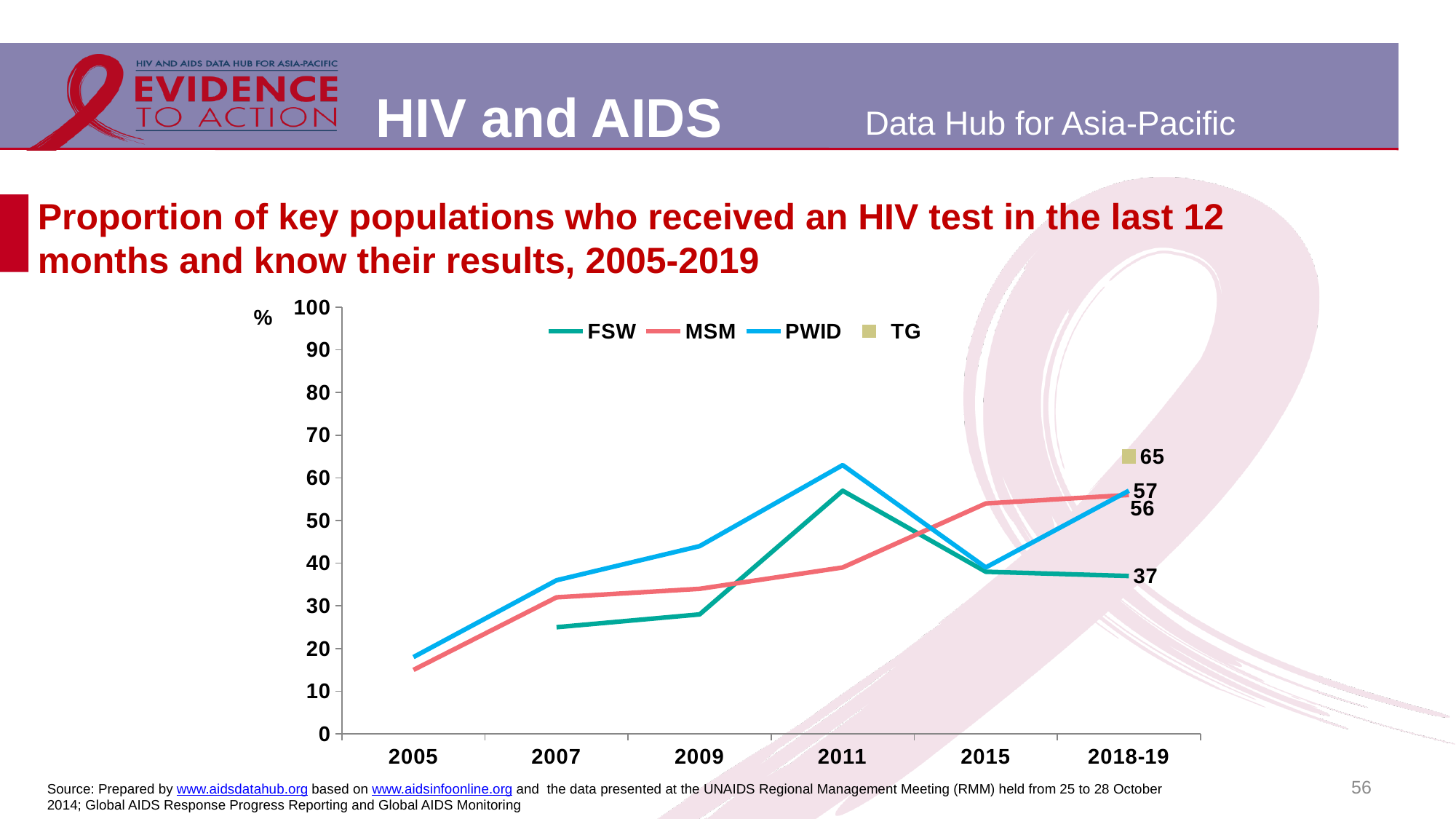
What is the value for PWID in 2018-19? 57 Which key population has the highest value in 2018-19? TG What type of chart is shown on the slide? line chart What is the value for TG in 2018-19? 65 How many time points are shown on the x axis? 6 What is the value for FSW in 2018-19? 37 How many series does the legend list? 4 Is the value for PWID in 2011 greater or less than 60? greater What is the difference between the TG and FSW values in 2018-19? 28 Which key population has the lowest value in 2018-19? FSW Is the value for MSM in 2005 greater or less than 20? less Does the FSW line rise or fall from 2011 to 2018-19? fall